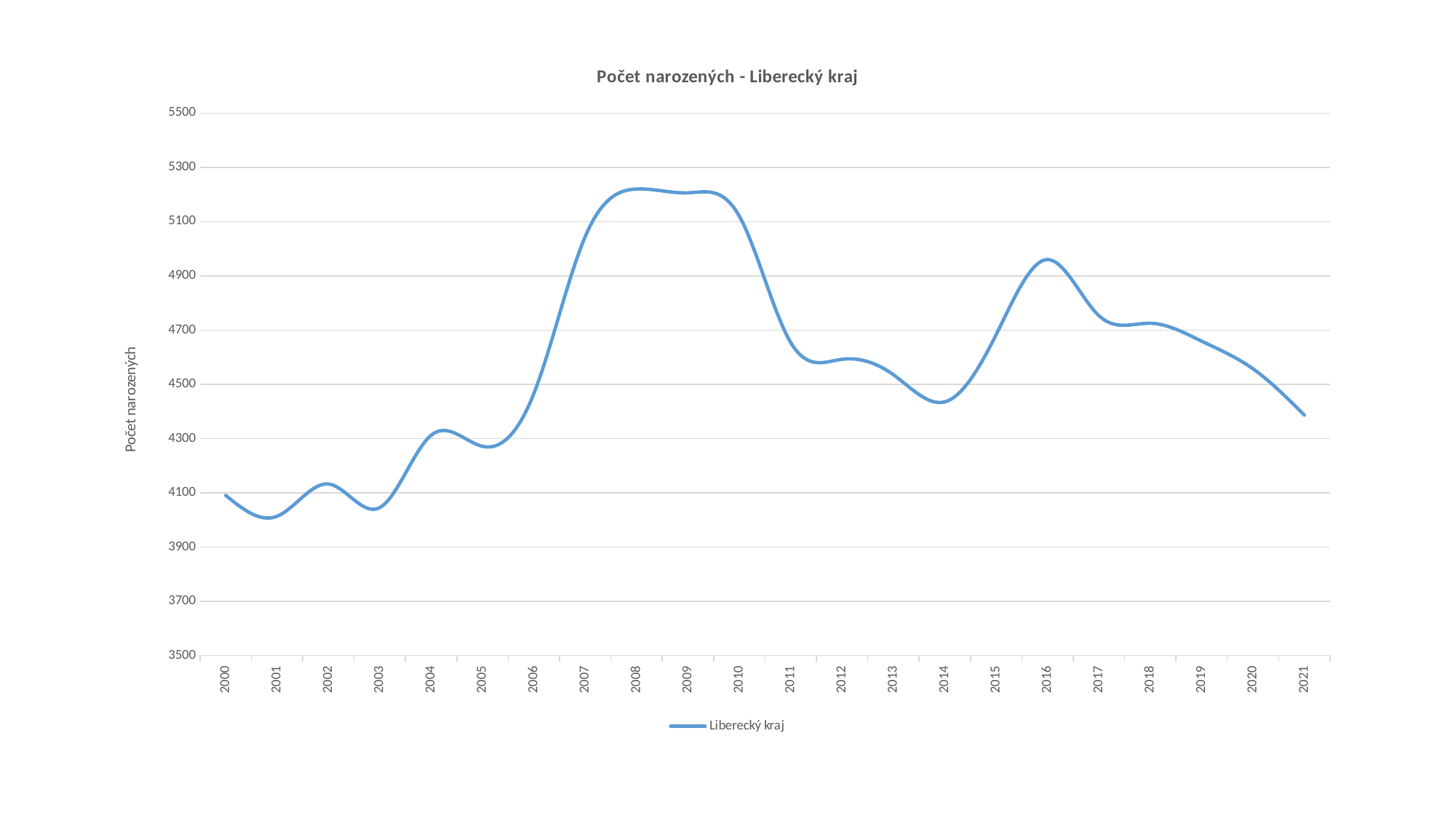
Do the values rise or fall from 2016 to 2021? fall Is the value for 2014 greater or less than 4500? less How many years are plotted along the x axis? 22 What kind of chart is shown on the slide? line chart Which year has the larger value, 2000 or 2021? 2021 Is the value for 2001 greater or less than 4100? less How many series does the legend list? 1 What is the title of the chart? Počet narozených - Liberecký kraj Which year has the larger value, 2008 or 2016? 2008 Is the value for 2008 greater or less than 5100? greater